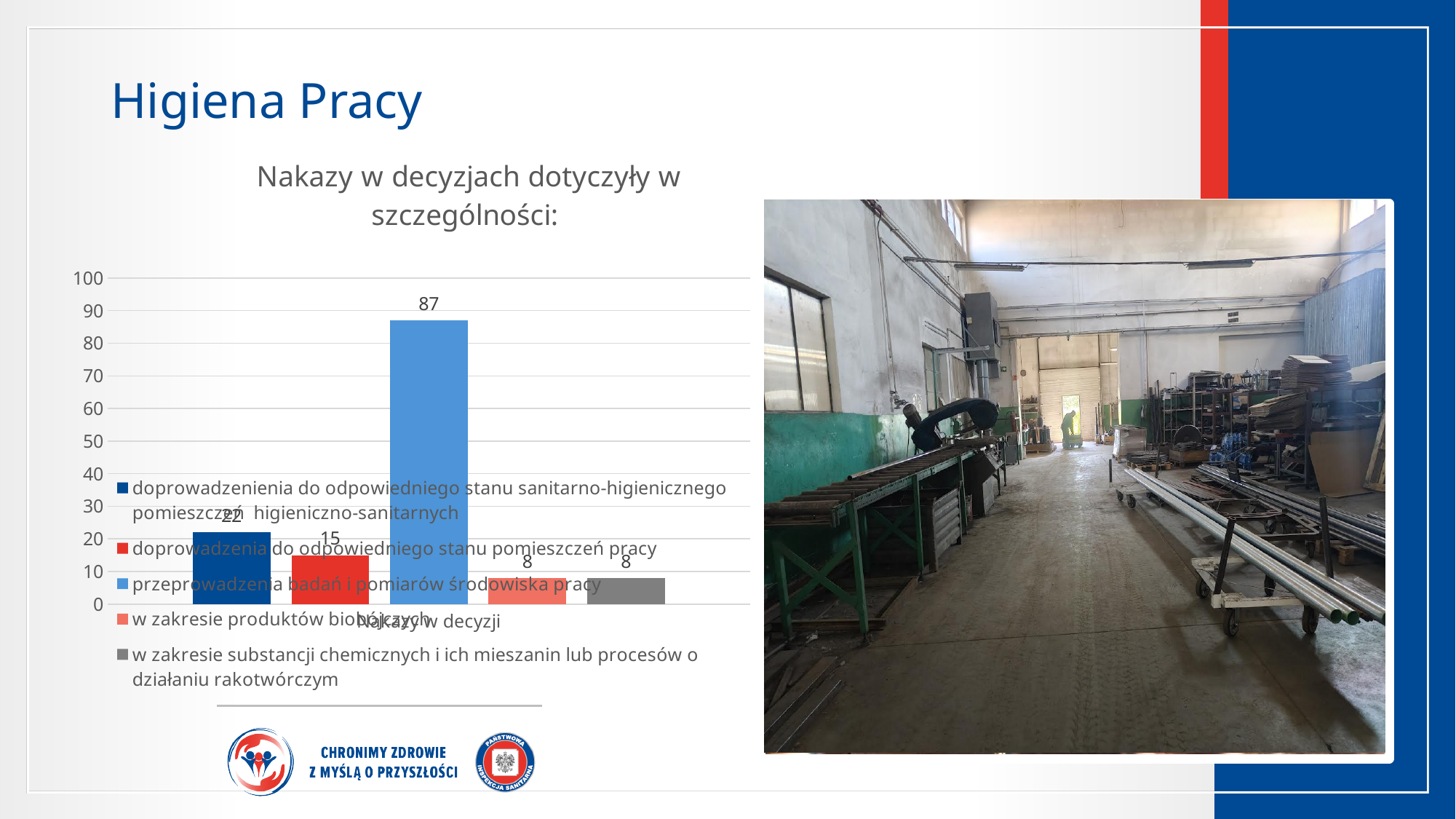
What is the difference between the value for "doprowadzenia do odpowiedniego stanu pomieszczeń pracy" and the value for "w zakresie substancji chemicznych i ich mieszanin lub procesów o działaniu rakotwórczym"? 7 What is the title of the chart? Nakazy w decyzjach dotyczyły w szczególności: Which is larger: the value for "doprowadzenienia do odpowiedniego stanu sanitarno-higienicznego pomieszczeń higieniczno-sanitarnych" or the value for "doprowadzenia do odpowiedniego stanu pomieszczeń pracy"? doprowadzenienia do odpowiedniego stanu sanitarno-higienicznego pomieszczeń higieniczno-sanitarnych How many series does the legend list? 5 What is the difference between the value for "przeprowadzenia badań i pomiarów środowiska pracy" and the value for "doprowadzenienia do odpowiedniego stanu sanitarno-higienicznego pomieszczeń higieniczno-sanitarnych"? 65 What is the value for "doprowadzenia do odpowiedniego stanu pomieszczeń pracy"? 15 What is the category label shown on the x axis of the chart? Nakazy w decyzji What type of chart is shown on the slide? bar chart What is the value for "doprowadzenienia do odpowiedniego stanu sanitarno-higienicznego pomieszczeń higieniczno-sanitarnych"? 22 Which series has the highest value? przeprowadzenia badań i pomiarów środowiska pracy What is the value for "w zakresie produktów biobójczych"? 8 What is the value for "przeprowadzenia badań i pomiarów środowiska pracy"? 87